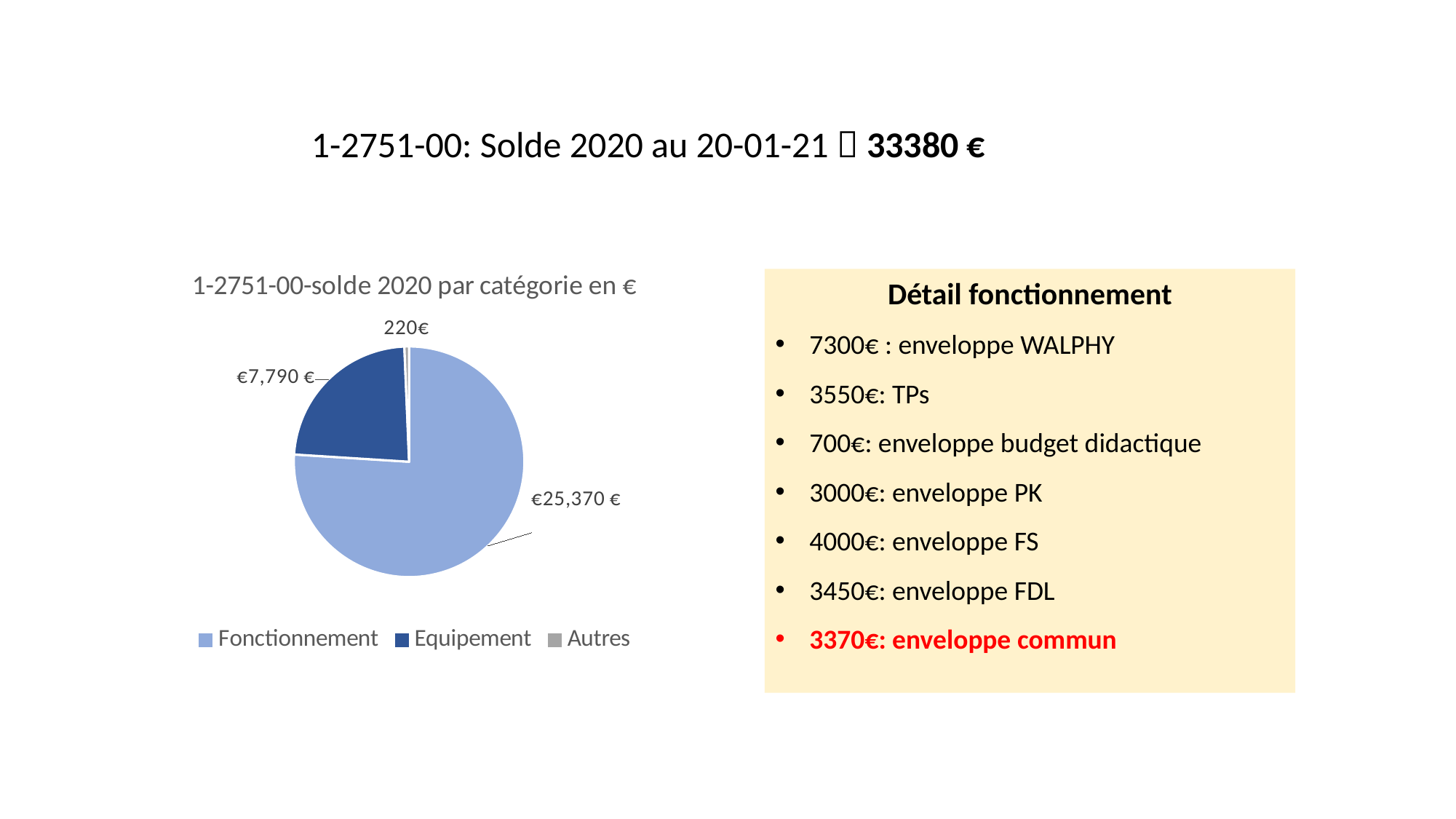
Which legend entry is shown in the darkest blue colour? Equipement What is the total of all slices in the pie chart? 33,380 € What is the difference between the Fonctionnement and Equipement values in the pie chart? 17,580 € What is the title of the chart? 1-2751-00-solde 2020 par catégorie en € Which is larger in the pie chart, Equipement or Autres? Equipement What is the value for Autres in the pie chart? 220€ What is the value for Fonctionnement in the pie chart? €25,370 € What type of chart is shown on the slide? pie chart Which category has the largest slice of the pie chart? Fonctionnement How many categories does the pie chart show? 3 Which category has the smallest slice of the pie chart? Autres What is the value for Equipement in the pie chart? €7,790 €